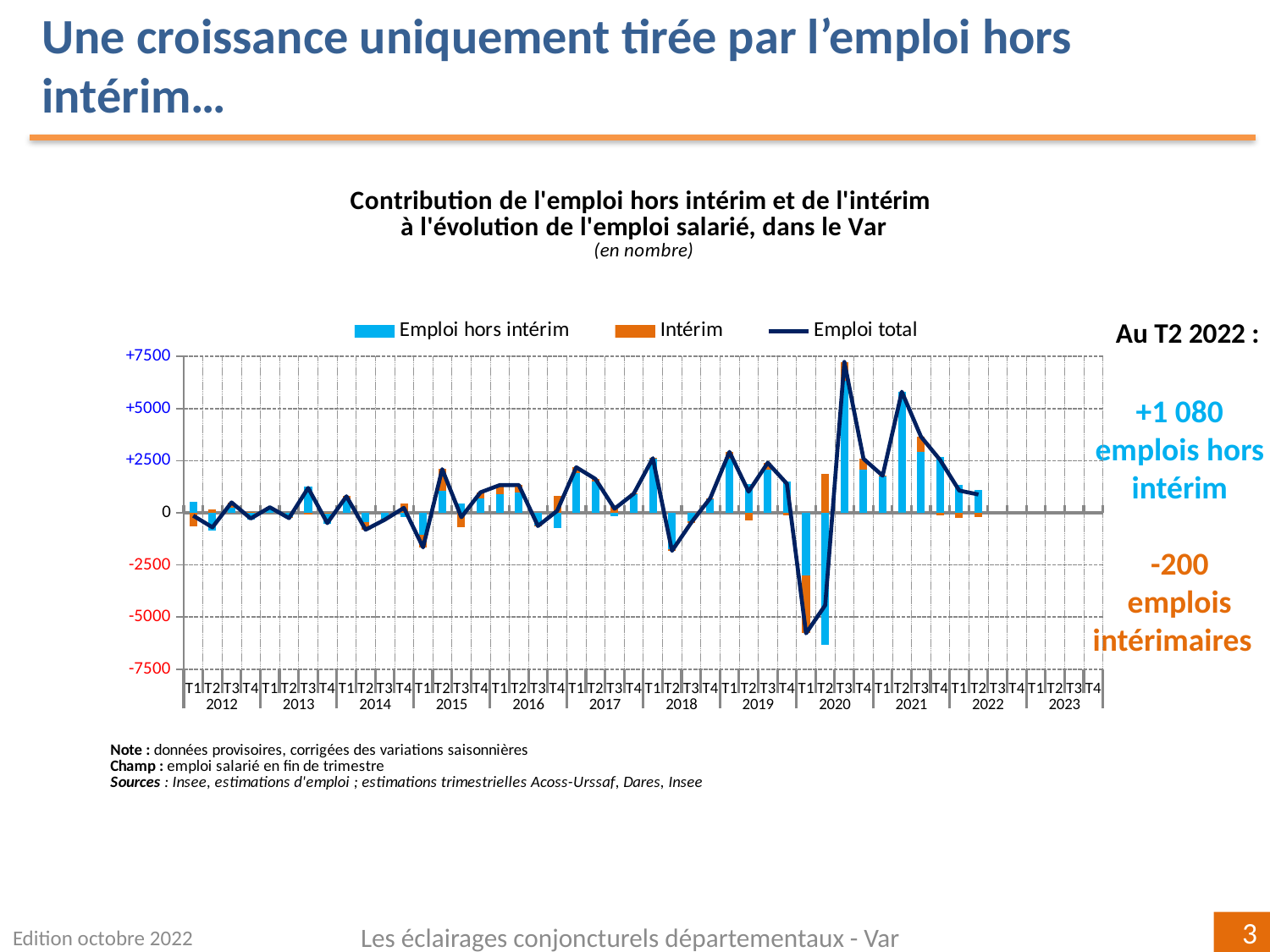
Is the value of Emploi total at T3 2020 greater or less than 5000? greater What colour are the Intérim bars in the chart? Orange In which quarter does the Emploi total line reach its lowest value? T1 2020 According to the slide, what is the value for Emploi hors intérim at T2 2022? +1 080 Which is larger: Emploi total at T3 2020 or Emploi total at T2 2021? T3 2020 In which quarter does the Emploi total line reach its highest value? T3 2020 Is the value of Emploi hors intérim at T2 2020 greater or less than -5000? less According to the slide, what is the value for Intérim at T2 2022? -200 How many series does the chart legend list? 3 What kind of chart is shown on the slide? A combined bar and line chart Is the value of Emploi total at T2 2018 greater or less than 0? less Between T1 2020 and T3 2020, does the Emploi total line rise or fall? rise